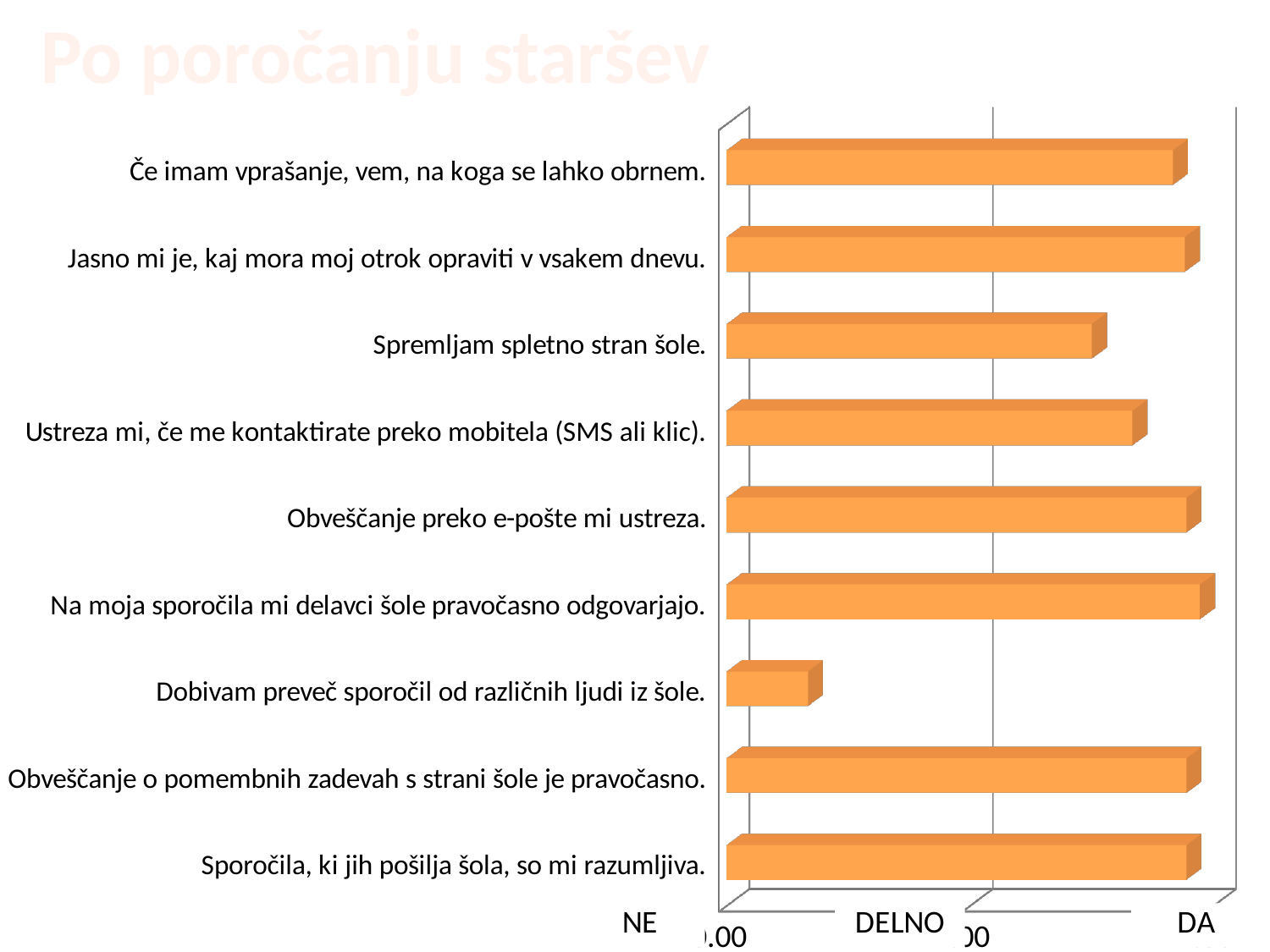
Does the bar for 'Dobivam preveč sporočil od različnih ljudi iz šole.' end to the left or to the right of the DELNO gridline? left Does the bar for 'Obveščanje preko e-pošte mi ustreza.' end closer to the DELNO label or to the DA label on the axis? DA Which statement has the lowest value in the chart? Dobivam preveč sporočil od različnih ljudi iz šole. Does the bar for 'Spremljam spletno stran šole.' end to the left or to the right of the DELNO gridline? right What colour are the bars in the chart? orange Which has the larger value: 'Spremljam spletno stran šole.' or 'Če imam vprašanje, vem, na koga se lahko obrnem.'? Če imam vprašanje, vem, na koga se lahko obrnem. What kind of chart is shown on the slide? bar chart What are the three labels shown along the horizontal axis of the chart? NE, DELNO, DA Which has the larger value: 'Dobivam preveč sporočil od različnih ljudi iz šole.' or 'Sporočila, ki jih pošilja šola, so mi razumljiva.'? Sporočila, ki jih pošilja šola, so mi razumljiva. How many statements (categories) are plotted in the chart? 9 Which has the larger value: 'Spremljam spletno stran šole.' or 'Ustreza mi, če me kontaktirate preko mobitela (SMS ali klic).'? Ustreza mi, če me kontaktirate preko mobitela (SMS ali klic). What is the title of the slide containing the chart? Po poročanju staršev